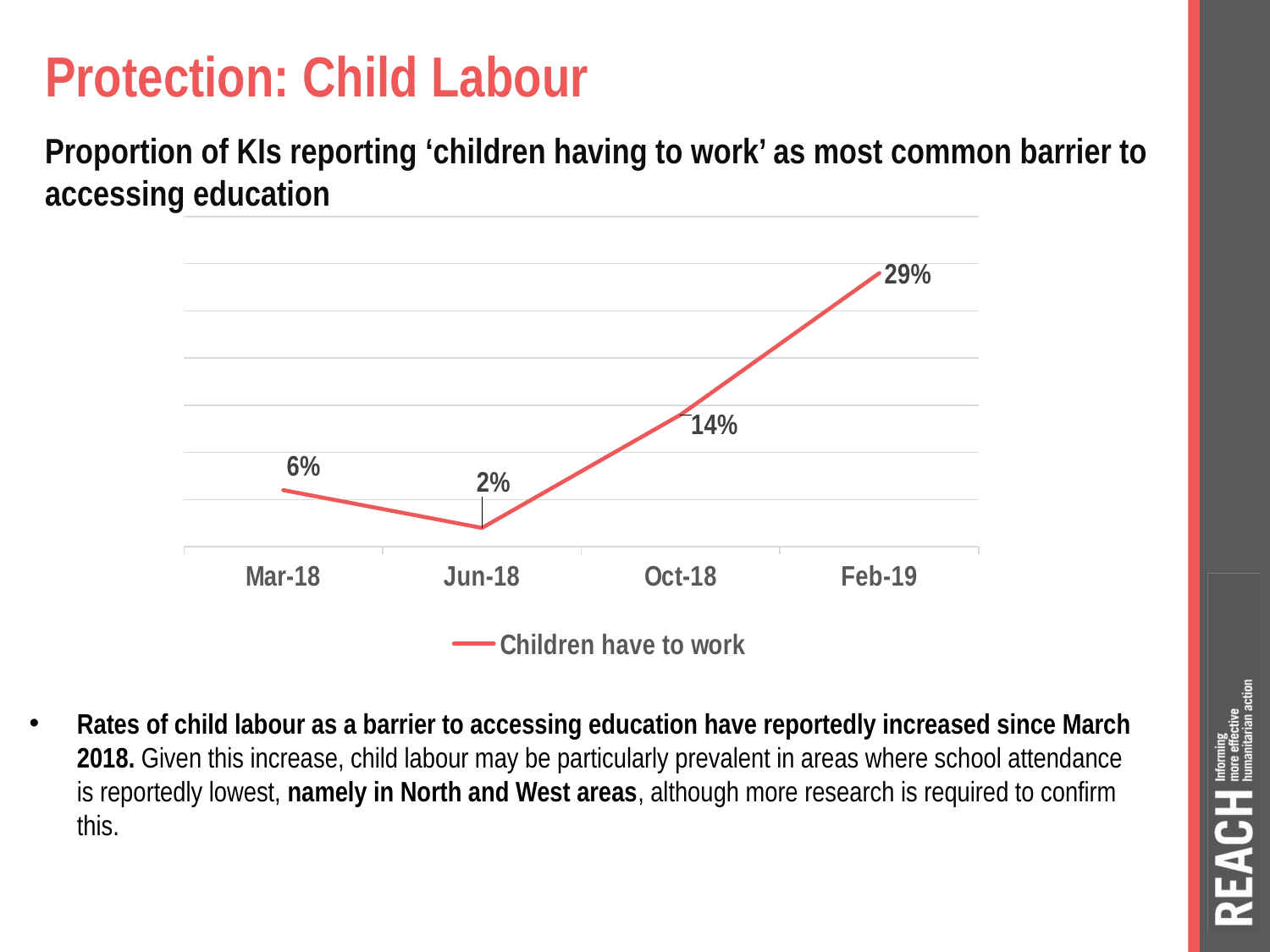
What is the difference between the values for Mar-18 and Jun-18? 4% What is the value for Feb-19? 29% Which is larger, the value for Mar-18 or the value for Oct-18? Oct-18 Which time point has the lowest value? Jun-18 What is the value for Oct-18? 14% Which time point has the highest value? Feb-19 How many time points are plotted on the chart? 4 What is the value for Jun-18? 2% What kind of chart is shown on the slide? Line chart What is the value for Mar-18? 6% What is the difference between the values for Feb-19 and Oct-18? 15% What series name does the legend show? Children have to work